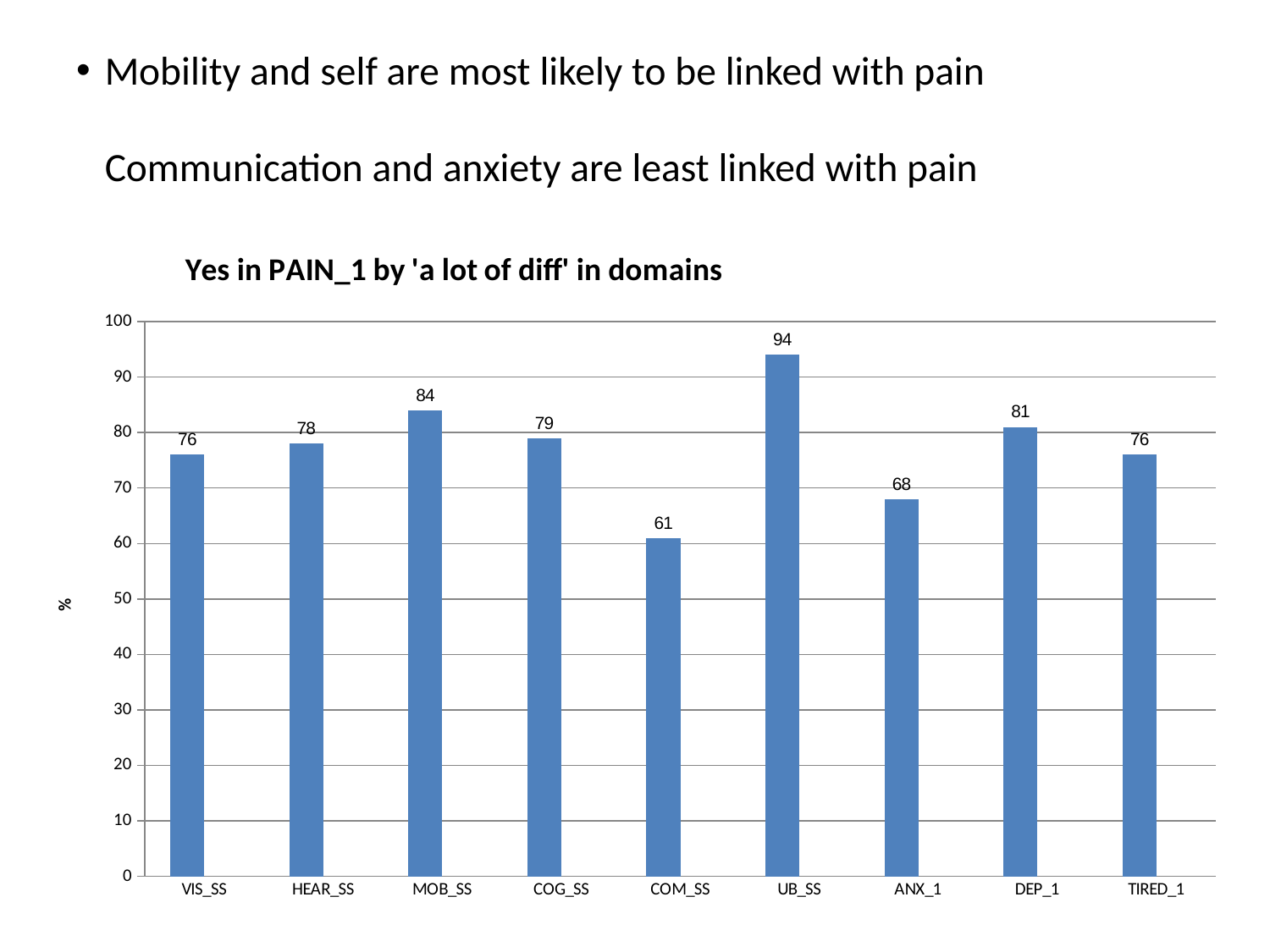
Is the value for ANX_1 greater or less than 70? less What kind of chart is shown on the slide? bar chart What is the title of the chart? Yes in PAIN_1 by 'a lot of diff' in domains How many categories are shown on the x axis? 9 Which category has the lowest value? COM_SS What is the value for COM_SS? 61 Which category has the highest value? UB_SS Which is larger, the value for HEAR_SS or the value for ANX_1? HEAR_SS What is the value for MOB_SS? 84 What is the difference between the values for UB_SS and COM_SS? 33 What is the value for DEP_1? 81 What is the difference between the values for MOB_SS and ANX_1? 16